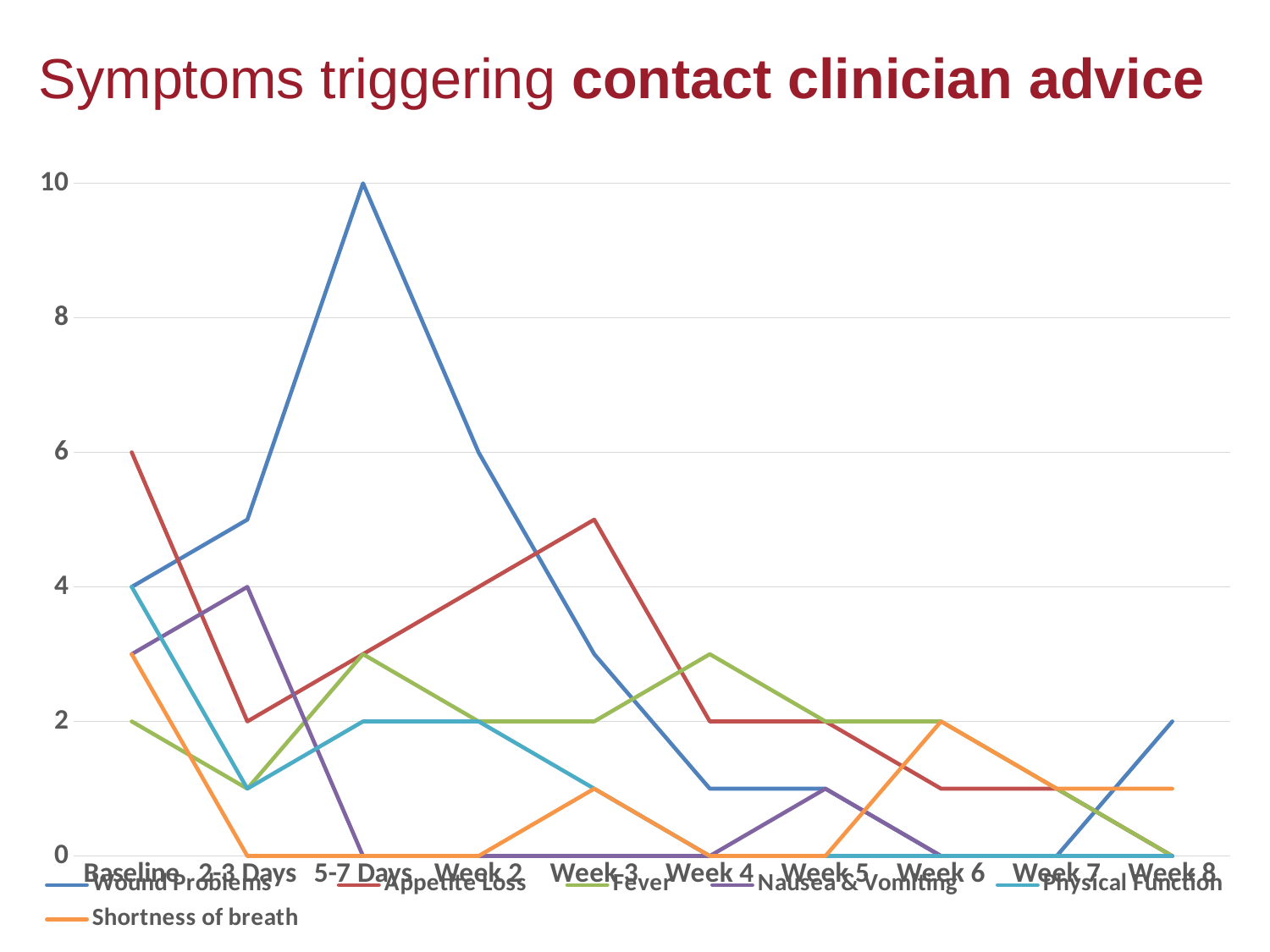
Does the Wound Problems line rise or fall from 5-7 Days to Week 6? fall What is the title of the chart? Symptoms triggering contact clinician advice Which series reaches the highest value on the chart? Wound Problems What kind of chart is shown on the slide? line chart Is the value for Wound Problems at Week 2 greater or less than 4? greater What is the value for Appetite Loss at Baseline? 6 At Baseline, which is larger: Appetite Loss or Wound Problems? Appetite Loss At which time point does the Wound Problems line reach its peak? 5-7 Days How many time points are shown along the x axis? 10 How many series does the legend list? 6 What is the value for Wound Problems at 5-7 Days? 10 What is the value for Nausea & Vomiting at 2-3 Days? 4